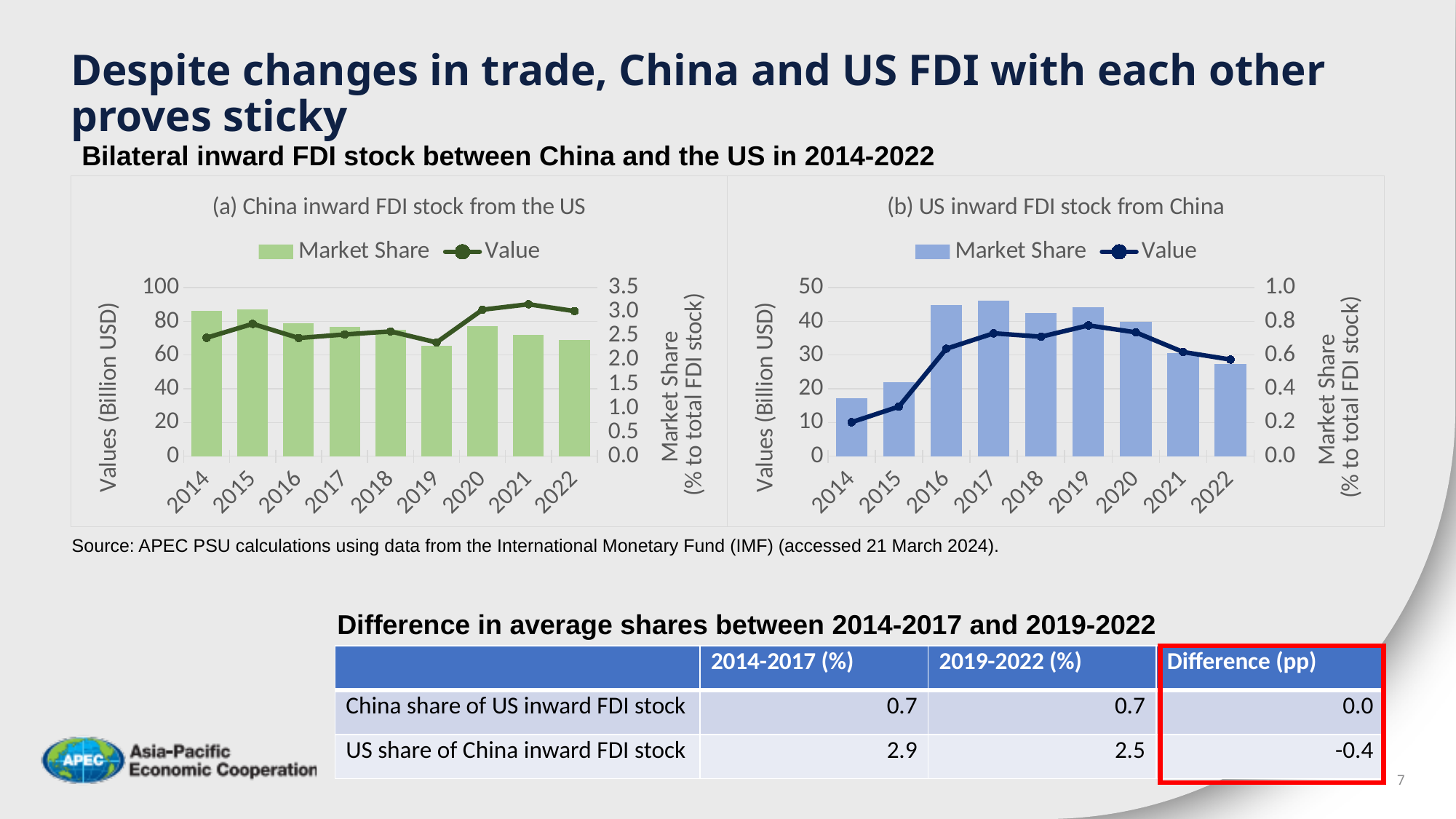
What is the label of the right-hand vertical axis on chart (a) China inward FDI stock from the US? Market Share (% to total FDI stock) On chart (b) US inward FDI stock from China, do the bars rise or fall from 2019 to 2022? fall On chart (a) China inward FDI stock from the US, is the bar for 2019 greater or less than 80 billion USD? less On chart (b) US inward FDI stock from China, is the line value for 2014 greater or less than 0.4 on the right axis? less On chart (a) China inward FDI stock from the US, is the bar for 2014 greater or less than 80 billion USD? greater On chart (a) China inward FDI stock from the US, how many years are shown on the x axis? 9 On chart (a) China inward FDI stock from the US, which bar is larger, 2019 or 2020? 2020 What kind of chart is chart (a) China inward FDI stock from the US? Combined bar and line chart On chart (b) US inward FDI stock from China, which year has the lowest bar? 2014 On chart (b) US inward FDI stock from China, how many series does the legend list? 2 On chart (b) US inward FDI stock from China, which bar is larger, 2014 or 2015? 2015